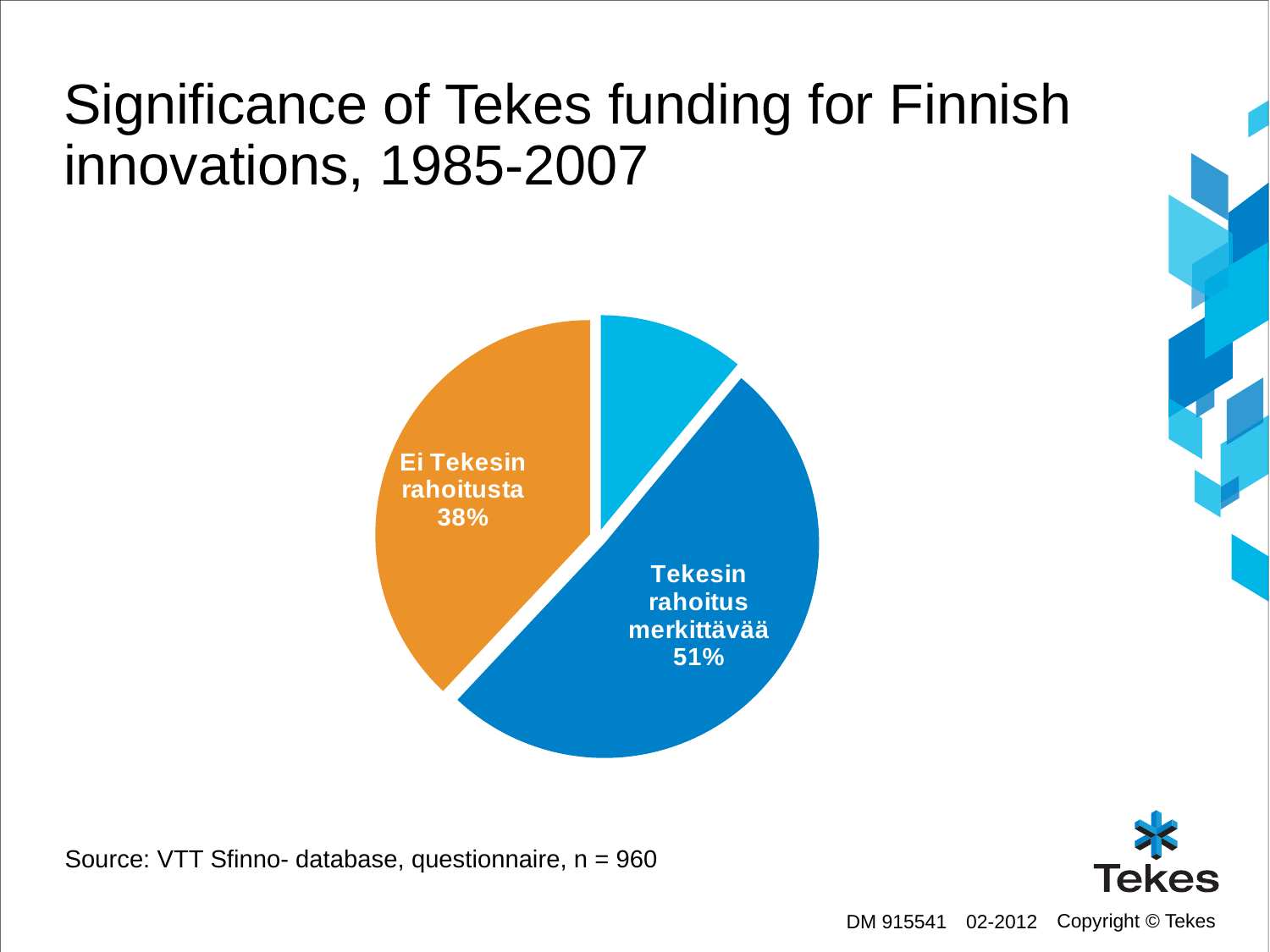
What share of the pie does the slice labelled "Ei Tekesin rahoitusta" represent? 38% What kind of chart is shown on the slide? Pie chart Which is larger: the "Ei Tekesin rahoitusta" slice or the "Tekesin rahoitus merkittävää" slice? Tekesin rahoitus merkittävää What share of the pie does the slice labelled "Tekesin rahoitus merkittävää" represent? 51% Which labelled slice of the pie is the largest? Tekesin rahoitus merkittävää How many slices does the pie chart have? 3 What colour is the "Ei Tekesin rahoitusta" slice? Orange Is the share for "Tekesin rahoitus merkittävää" greater or less than 50%? greater Is the share for "Ei Tekesin rahoitusta" greater or less than 40%? less What is the title of the slide containing the pie chart? Significance of Tekes funding for Finnish innovations, 1985-2007 By how many percentage points does the "Tekesin rahoitus merkittävää" slice exceed the "Ei Tekesin rahoitusta" slice? 13 percentage points